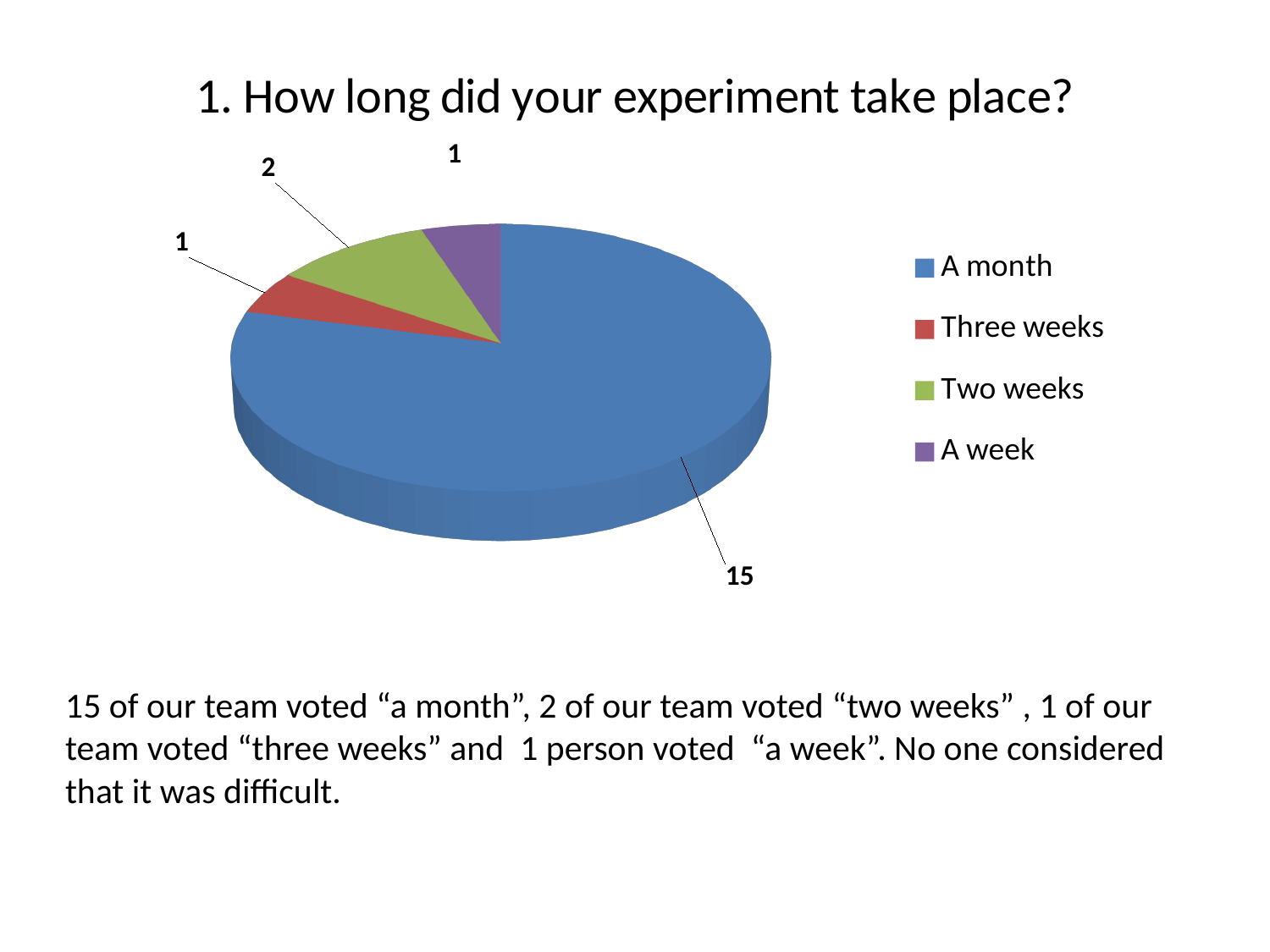
What value is shown for the "A week" slice? 1 What colour is the "A month" slice in the pie chart? blue What value is shown for the "Two weeks" slice? 2 Which category has the largest slice of the pie? A month What value is shown for the "Three weeks" slice? 1 What type of chart is shown on the slide? pie chart How many people voted "A month" according to the pie chart? 15 What is the title of the chart? 1. How long did your experiment take place? How many categories does the pie chart have? 4 Which is larger, the value for "Two weeks" or the value for "Three weeks"? Two weeks What is the difference between the values for "A month" and "Two weeks"? 13 What is the total of all the values shown on the pie chart? 19